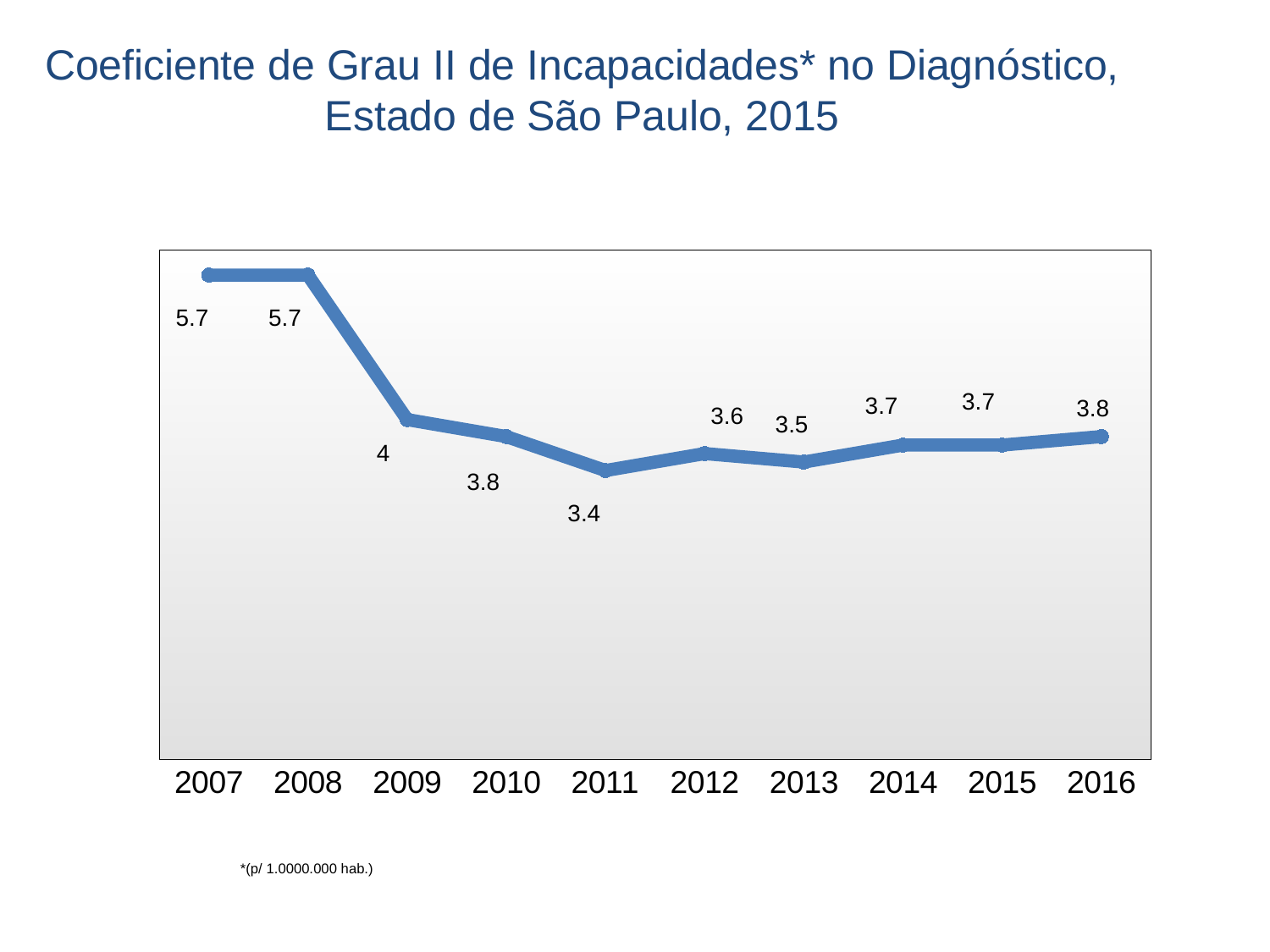
What is the value for 2009? 4 What is the value for 2011? 3.4 What is the highest value shown on the chart? 5.7 What kind of chart is shown on the slide? Line chart What is the difference between the values for 2016 and 2011? 0.4 What is the difference between the values for 2008 and 2009? 1.7 Which is larger, the value for 2012 or the value for 2013? 2012 What is the value for 2016? 3.8 How many years are plotted on the x axis? 10 Do the values rise or fall from 2007 to 2011? Fall Which year has the lowest value? 2011 What is the value for 2013? 3.5